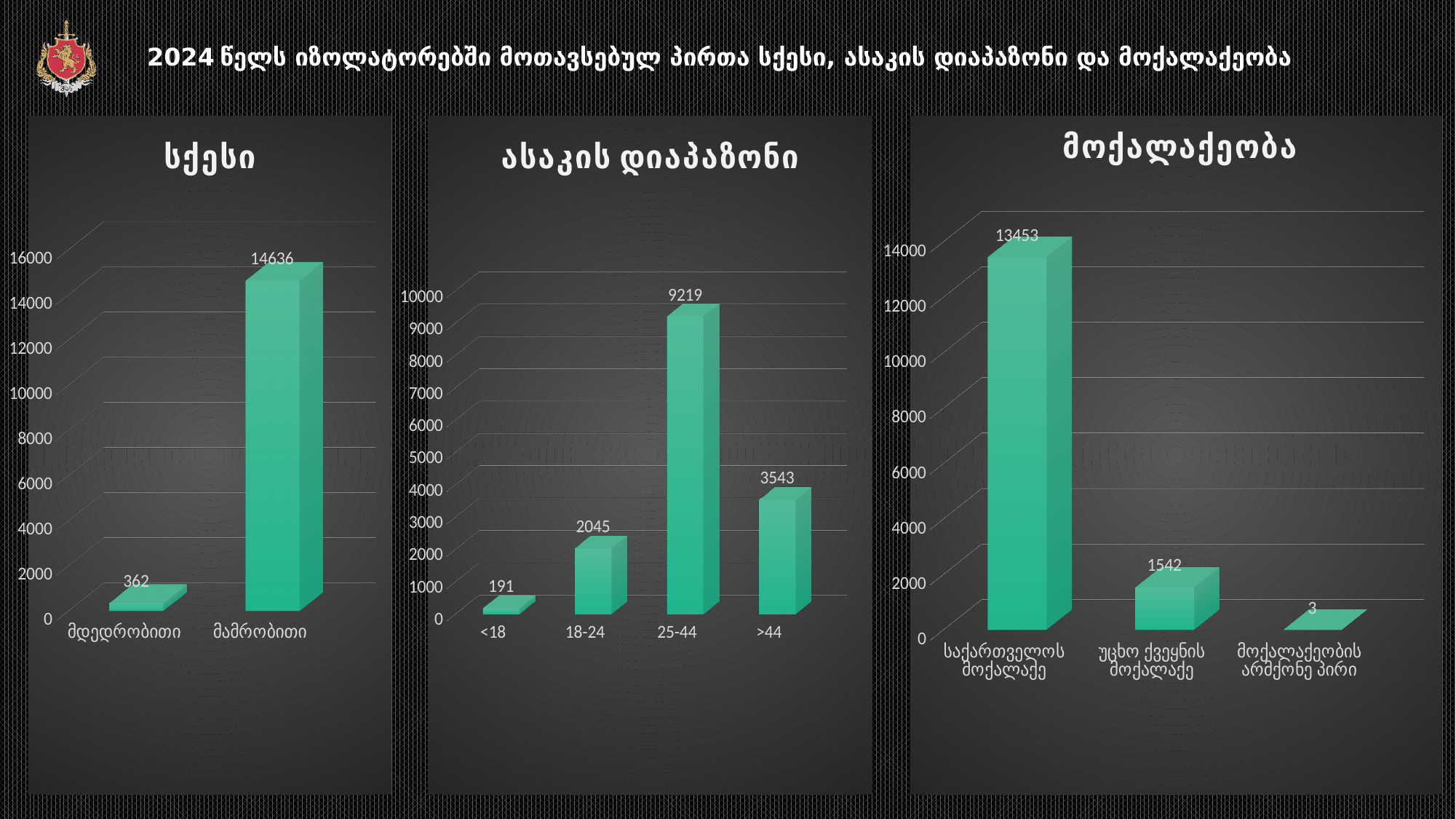
In the right chart titled "მოქალაქეობა", what is the value for უცხო ქვეყნის მოქალაქე? 1542 In the left chart titled "სქესი", what is the difference between the values for მამრობითი and მდედრობითი? 14274 In the middle chart titled "ასაკის დიაპაზონი", what is the value for the 25-44 age group? 9219 In the right chart titled "მოქალაქეობა", what is the value for მოქალაქეობის არმქონე პირი? 3 In the left chart titled "სქესი", what is the value for მდედრობითი? 362 In the middle chart titled "ასაკის დიაპაზონი", which is larger, the value for 18-24 or the value for >44? >44 In the middle chart titled "ასაკის დიაპაზონი", how many age groups are shown? 4 In the middle chart titled "ასაკის დიაპაზონი", what is the difference between the values for >44 and 18-24? 1498 In the middle chart titled "ასაკის დიაპაზონი", which age group has the lowest value? <18 In the left chart titled "სქესი", what is the value for მამრობითი? 14636 What type of chart is the right chart titled "მოქალაქეობა"? Bar chart In the right chart titled "მოქალაქეობა", which category has the highest value? საქართველოს მოქალაქე